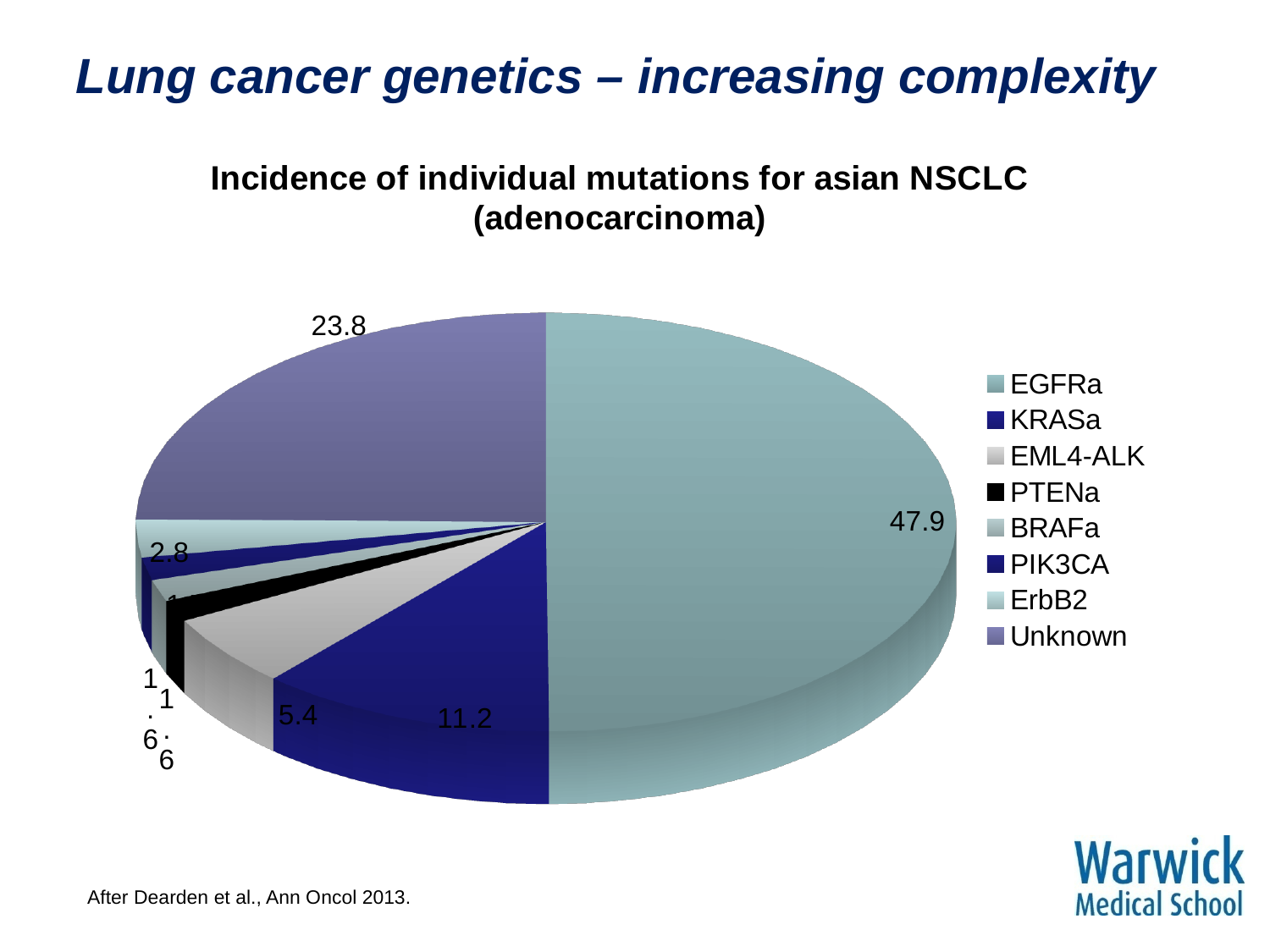
What is the value shown for EGFRa? 47.9 What is the value shown for EML4-ALK? 5.4 What is the value shown for the Unknown slice? 23.8 What type of chart is shown on the slide? Pie chart Which mutation category has the largest slice of the pie? EGFRa Which is larger, the KRASa slice or the Unknown slice? Unknown What is the title of the chart? Incidence of individual mutations for asian NSCLC (adenocarcinoma) What is the difference between the EGFRa value and the Unknown value? 24.1 How many categories does the legend list? 8 What is the difference between the KRASa value and the EML4-ALK value? 5.8 What is the value shown for KRASa? 11.2 What is the value shown for ErbB2? 2.8